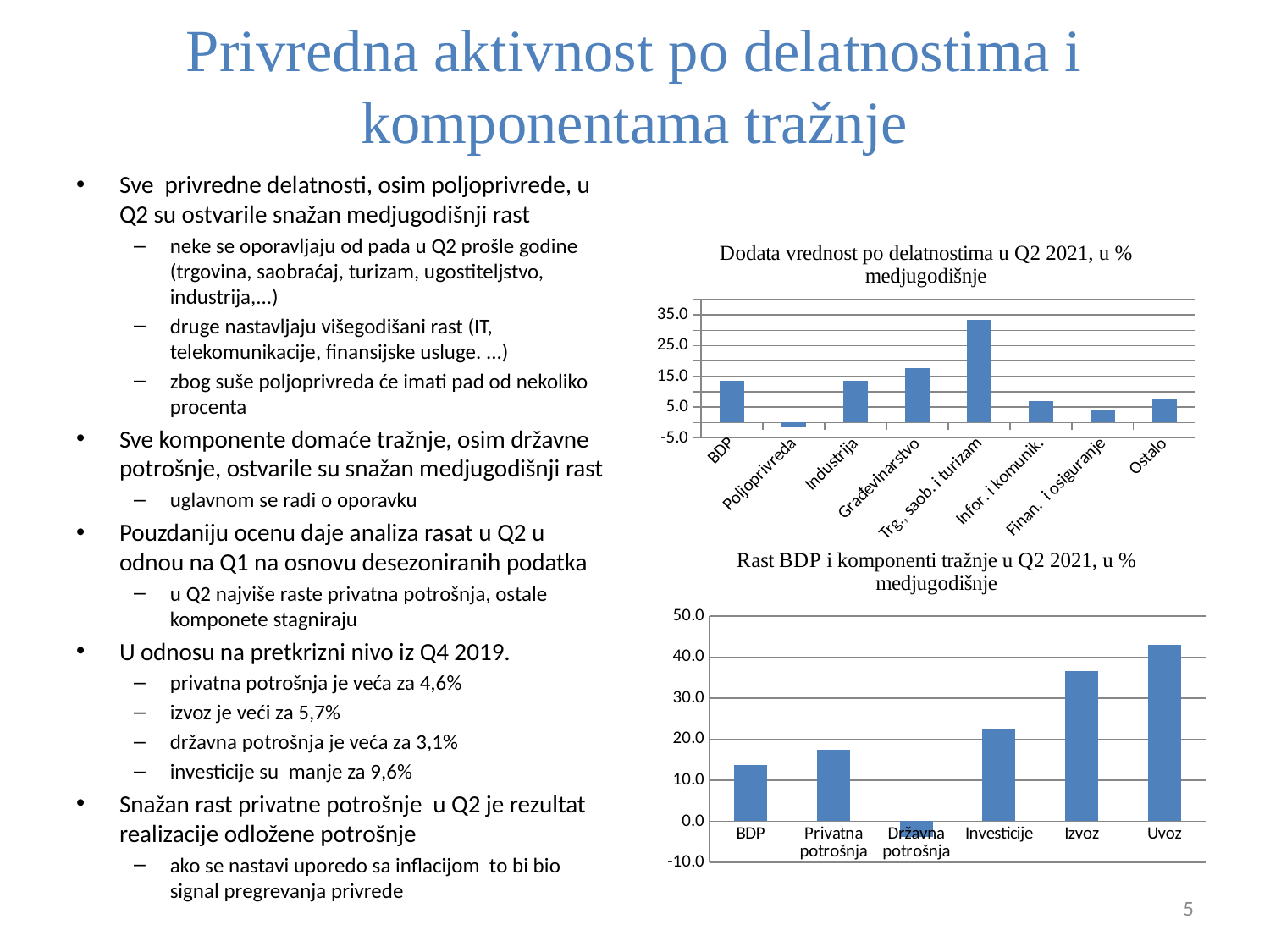
How many categories are shown in the bottom chart "Rast BDP i komponenti tražnje u Q2 2021"? 6 How many categories are shown in the top chart "Dodata vrednost po delatnostima u Q2 2021"? 8 In the bottom chart "Rast BDP i komponenti tražnje u Q2 2021", which category has the highest value? Uvoz In the bottom chart "Rast BDP i komponenti tražnje u Q2 2021", which category has the lowest value? Državna potrošnja In the top chart "Dodata vrednost po delatnostima u Q2 2021", which category has the highest value? Trg., saob. i turizam In the bottom chart "Rast BDP i komponenti tražnje u Q2 2021", is the value for Izvoz greater or less than 30.0? greater In the bottom chart "Rast BDP i komponenti tražnje u Q2 2021", which is larger: Privatna potrošnja or Investicije? Investicije In the top chart "Dodata vrednost po delatnostima u Q2 2021", is the value for Trg., saob. i turizam greater or less than 25.0? greater In the top chart "Dodata vrednost po delatnostima u Q2 2021", which is larger: Infor. i komunik. or Finan. i osiguranje? Infor. i komunik. In the top chart "Dodata vrednost po delatnostima u Q2 2021", is the value for Građevinarstvo greater or less than 15.0? greater In the top chart "Dodata vrednost po delatnostima u Q2 2021", which category has the lowest value? Poljoprivreda What kind of chart is the top chart titled "Dodata vrednost po delatnostima u Q2 2021"? bar chart